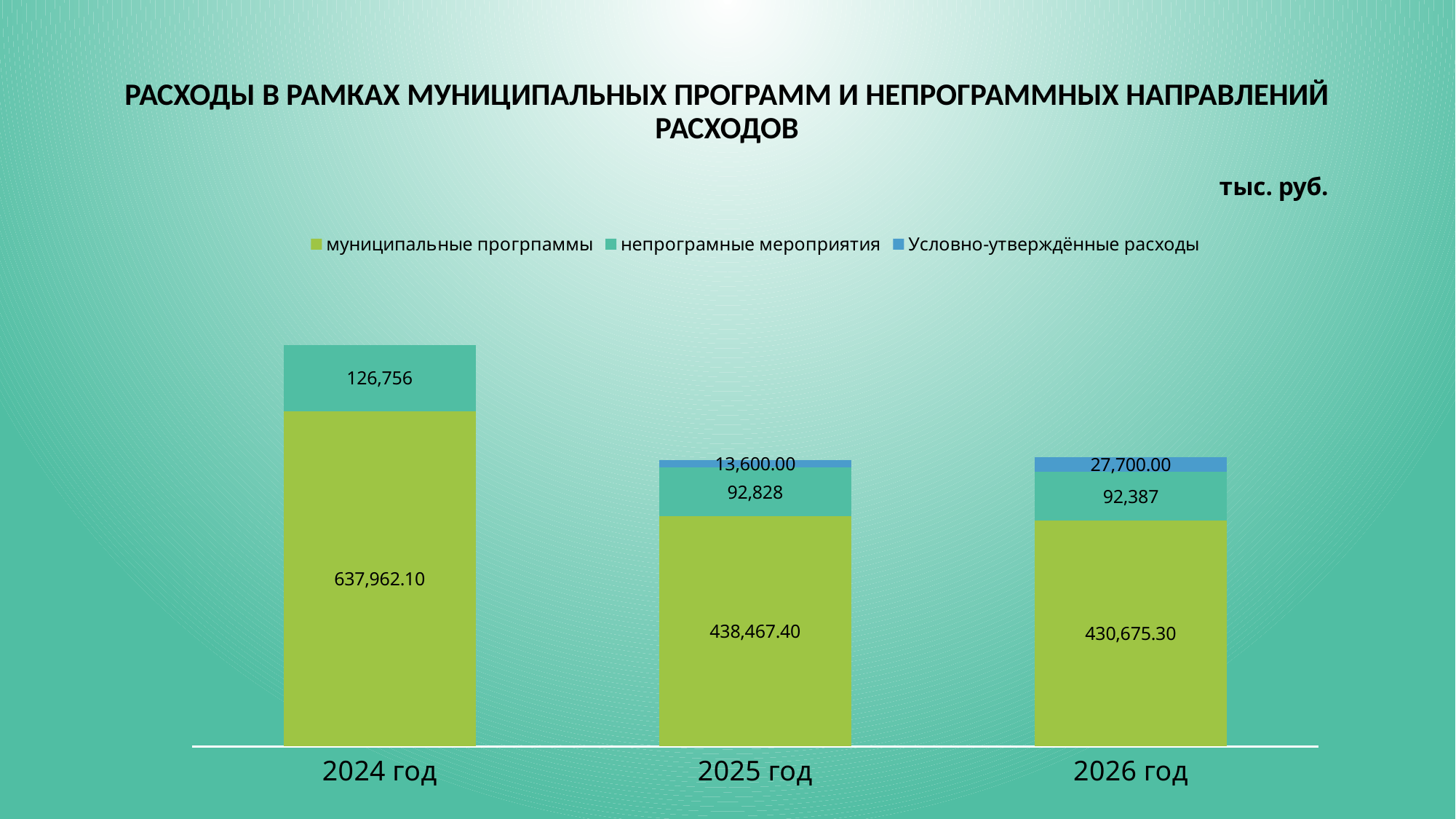
What is the value of 'непрограмные мероприятия' for 2025 год? 92,828 How many series does the legend list? 3 How many year categories are shown on the x axis? 3 What is the difference between the 'муниципальные програмы' values for 2024 год and 2025 год? 199,494.70 What is the value of 'муниципальные програмы' for 2024 год? 637,962.10 What is the difference between the 'Условно-утверждённые расходы' values for 2026 год and 2025 год? 14,100.00 Which year has the highest value for 'муниципальные програмы'? 2024 год Which year has the lowest value for 'непрограмные мероприятия'? 2026 год What is the value of 'Условно-утверждённые расходы' for 2026 год? 27,700.00 What is the total of the stacked bar for 2025 год? 544,895.40 What type of chart is shown on the slide? stacked bar chart What unit is indicated for the values on the chart? тыс. руб.